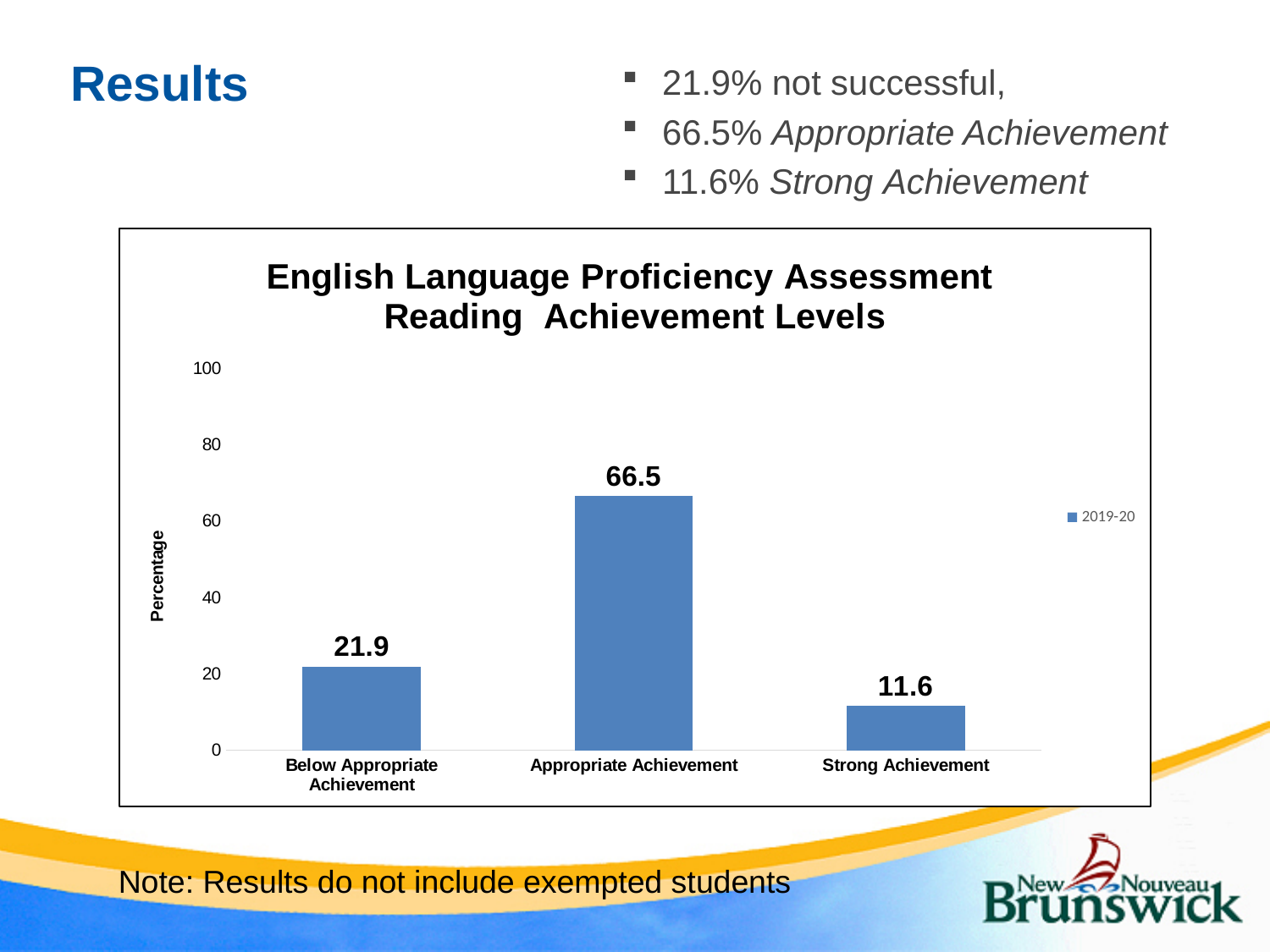
What is the value for Strong Achievement? 11.6 Is the value for Appropriate Achievement greater or less than 60? greater How many categories are shown on the x axis? 3 Which is larger, the value for Below Appropriate Achievement or the value for Strong Achievement? Below Appropriate Achievement What is the difference between the values for Appropriate Achievement and Below Appropriate Achievement? 44.6 Which category has the lowest value? Strong Achievement What is the value for Appropriate Achievement? 66.5 What is the value for Below Appropriate Achievement? 21.9 What kind of chart is shown? bar chart What is the difference between the values for Below Appropriate Achievement and Strong Achievement? 10.3 Which category has the highest value? Appropriate Achievement How many series does the legend list? 1